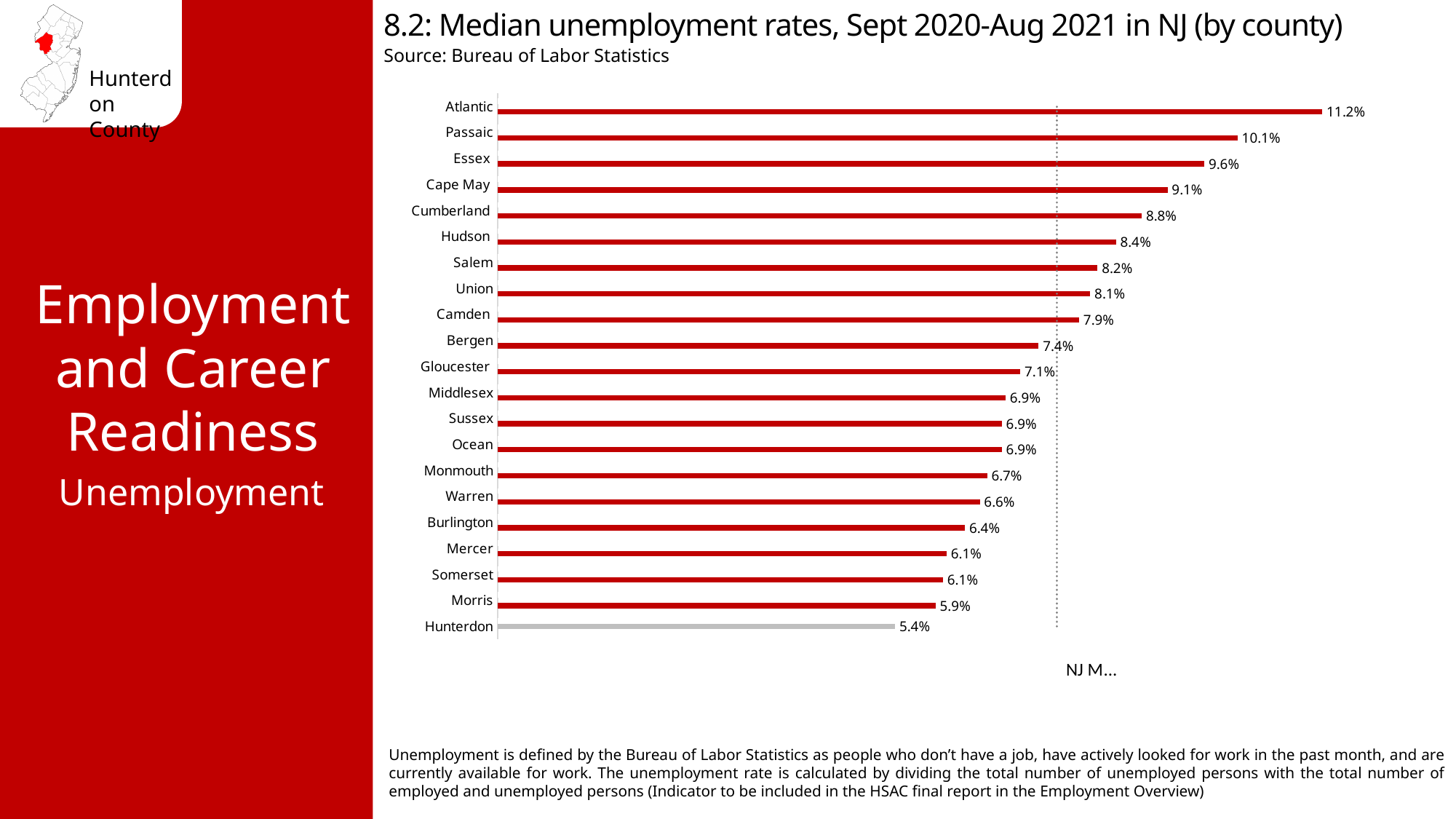
Which county has the highest median unemployment rate? Atlantic What is the median unemployment rate for Warren County? 6.6% What is the difference between the median unemployment rates of Atlantic and Hunterdon counties? 5.8% Which county's bar is shown in grey instead of red? Hunterdon Which county has a higher median unemployment rate, Morris or Bergen? Bergen What type of chart is used to show the median unemployment rates? Bar chart Which county has a higher median unemployment rate, Cape May or Camden? Cape May Which county has the lowest median unemployment rate? Hunterdon How many counties are shown in the chart? 21 What is the difference between the median unemployment rates of Passaic and Essex counties? 0.5% What is the median unemployment rate for Hunterdon County? 5.4% What is the median unemployment rate for Hudson County? 8.4%